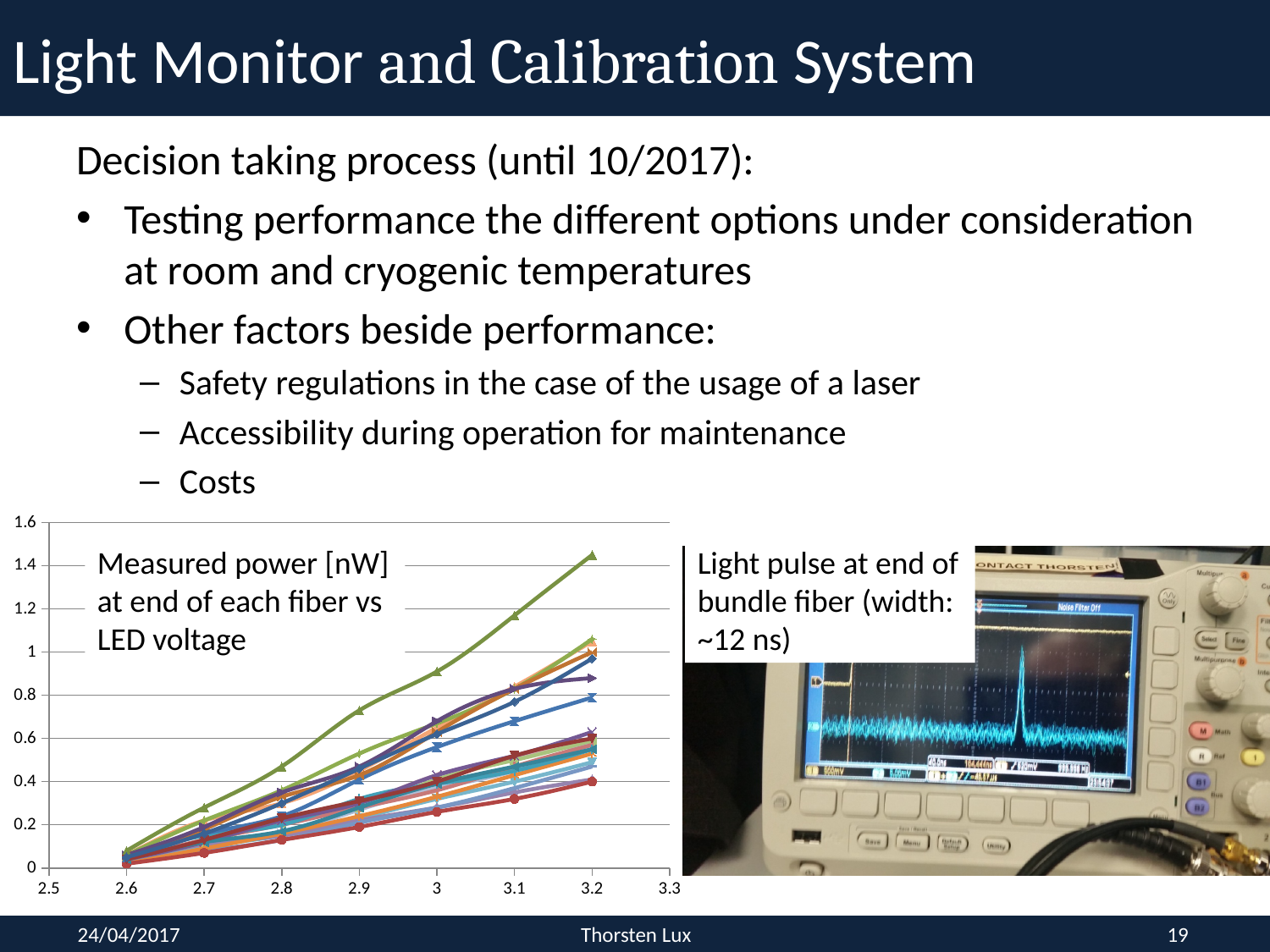
Is the value of the topmost line at an LED voltage of 2.6 greater or less than 0.2? less What is the highest tick value shown on the vertical axis of the chart? 1.6 Is the value of the lowest line at an LED voltage of 3.2 greater or less than 0.2? greater According to the text on the chart, what is plotted on the horizontal axis? LED voltage Is the value of the lowest line at an LED voltage of 3.2 greater or less than 0.6? less What kind of chart is shown at the bottom left of the slide? line chart At an LED voltage of 3.2, which is larger: the value of the topmost line or the value of the lowest line? the topmost line Do the measured power values rise or fall as the LED voltage increases along the x axis? rise According to the text on the chart, what quantity is plotted on the vertical axis? Measured power [nW] How many LED voltage points are plotted for each line in the chart? 7